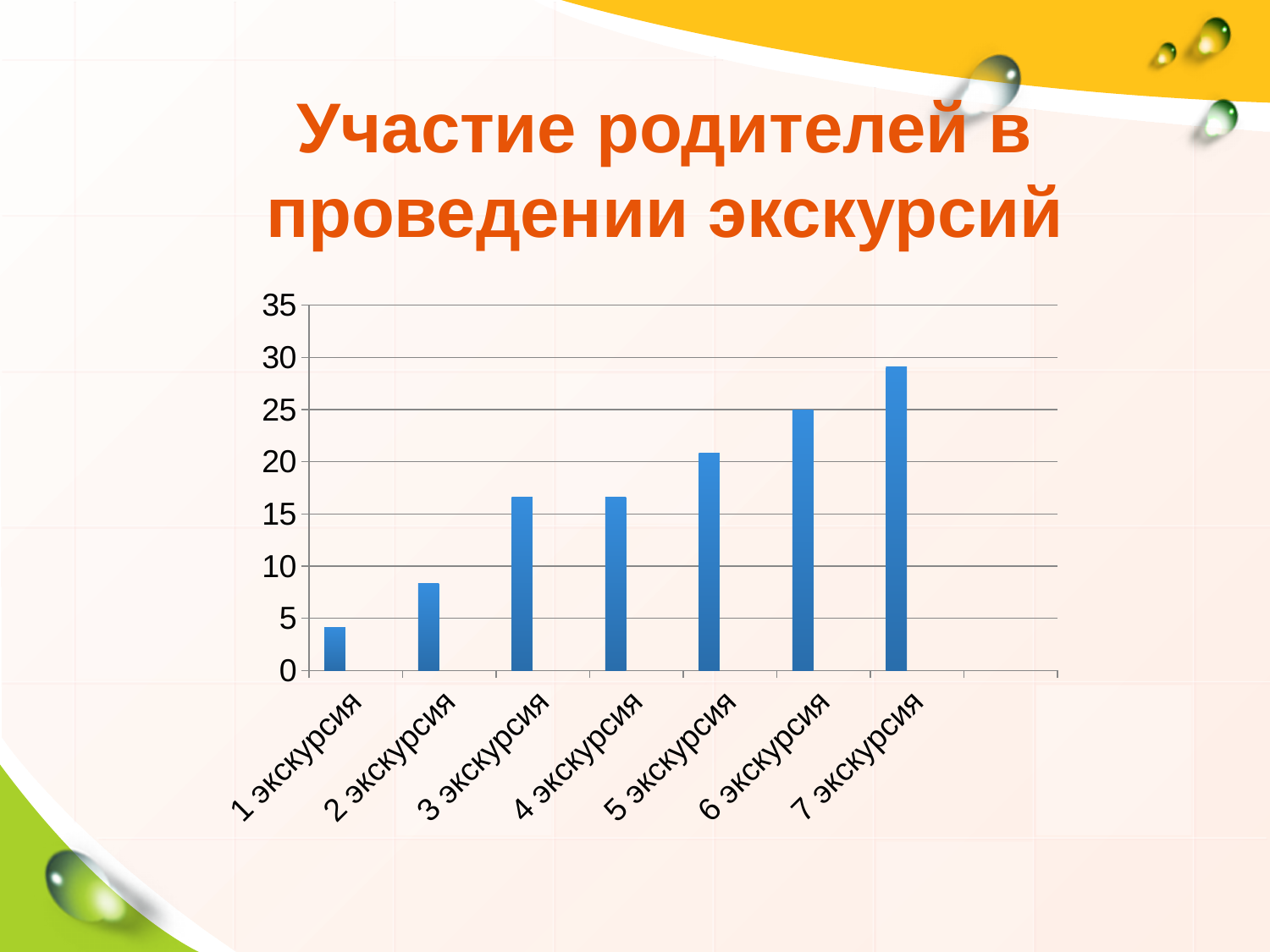
Which excursion has the lowest bar? 1 экскурсия What is the title of the slide containing the chart? Участие родителей в проведении экскурсий Do the values generally rise or fall from 1 экскурсия to 7 экскурсия? rise Is the value for 3 экскурсия greater or less than 15? greater Is the value for 2 экскурсия greater or less than 10? less Which excursion has the highest bar? 7 экскурсия How many excursions (categories) are shown on the x axis? 7 What kind of chart is shown on the slide? bar chart Is the value for 5 экскурсия greater or less than 20? greater Which is larger, the value for 5 экскурсия or the value for 2 экскурсия? 5 экскурсия